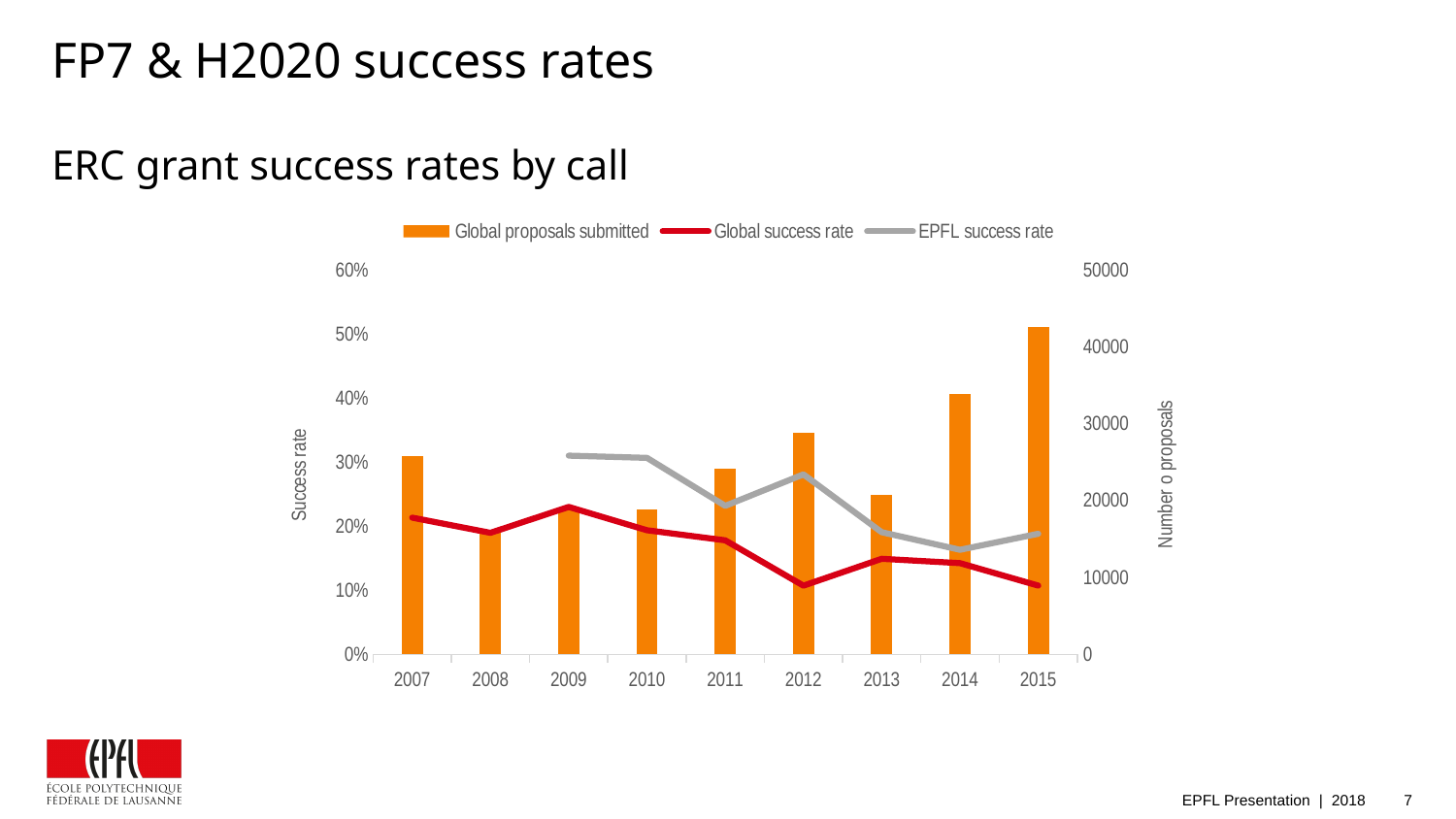
Does the global success rate generally rise or fall from 2007 to 2015? Fall What is the title of the right-hand vertical axis? Number o proposals In 2010, which is higher: the EPFL success rate or the global success rate? EPFL success rate How many years are shown on the x axis? 9 Is the number of global proposals submitted in 2008 greater or less than 20000? less Which year has the highest number of global proposals submitted? 2015 Which year has the lowest number of global proposals submitted? 2008 Is the number of global proposals submitted in 2015 greater or less than 40000? greater Is the global success rate in 2012 greater or less than 20%? less What kind of chart is this? Combined bar and line chart How many series does the legend list? 3